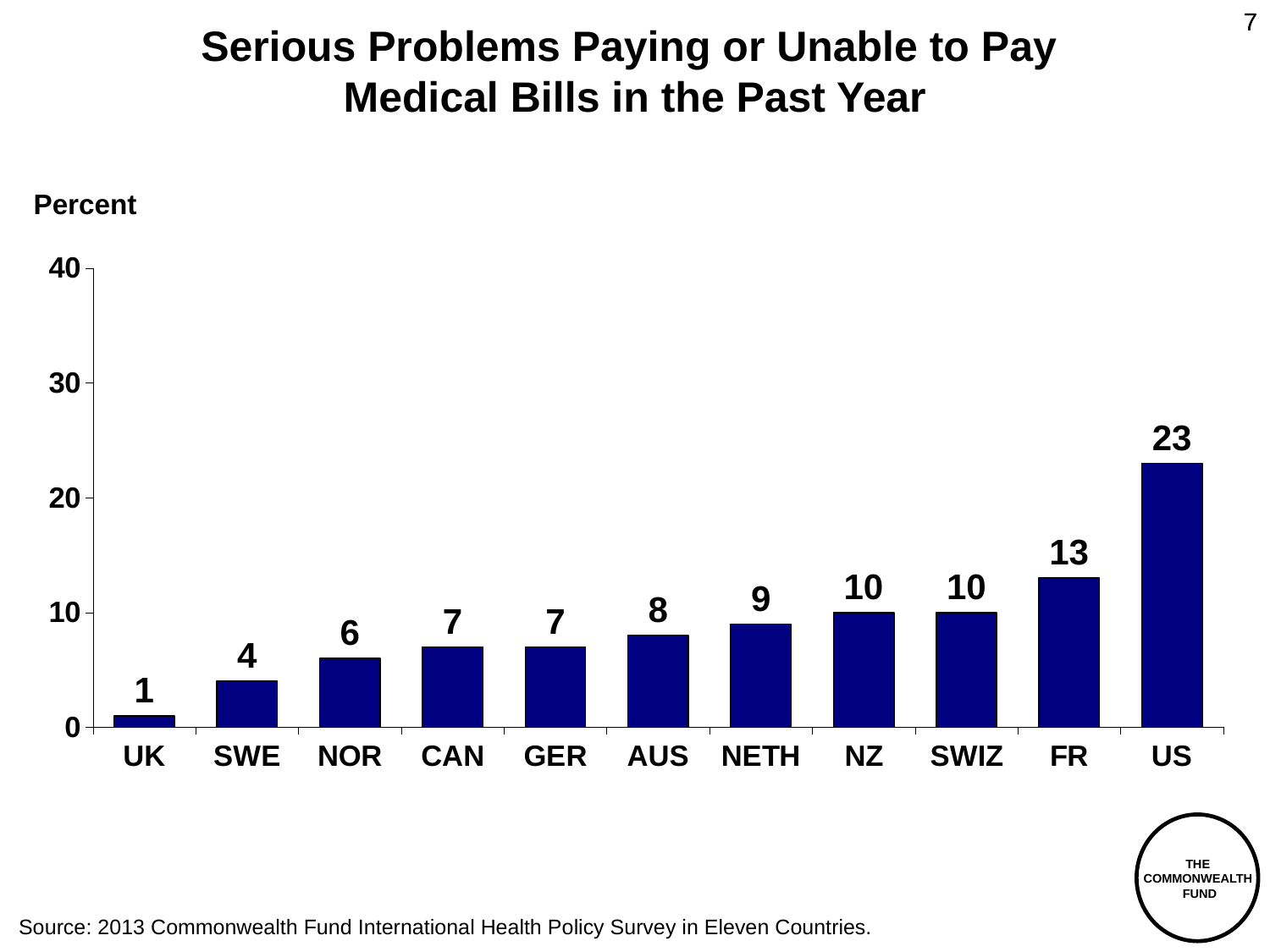
What is the value for SWE? 4 Which country has the highest value? US Which country has the lowest value? UK Do the values generally rise or fall from left to right along the x axis? rise What is the difference between the values for NOR and UK? 5 Which is larger, the value for AUS or the value for CAN? AUS Is the value for the US greater or less than 20? greater What is the value for the US? 23 How many countries are shown on the chart? 11 What is the value for NETH? 9 What is the difference between the values for the US and FR? 10 What kind of chart is shown on the slide? bar chart